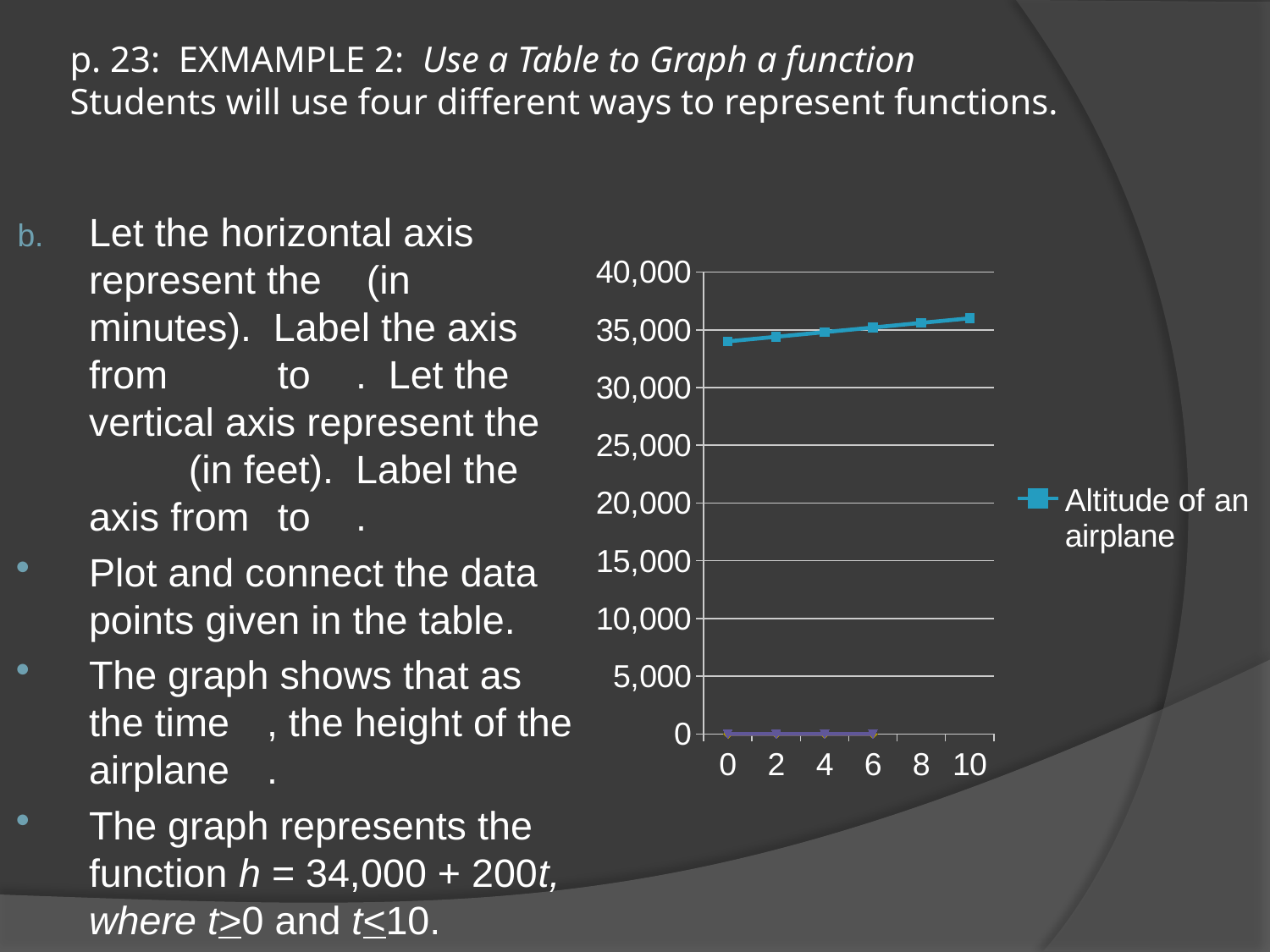
Is the altitude of the airplane at time 10 greater or less than 35,000? greater What is the highest value labelled on the chart's vertical axis? 40,000 At which x-axis value is the altitude of the airplane highest? 10 What is the name of the series shown in the chart's legend? Altitude of an airplane At which x-axis value is the altitude of the airplane lowest? 0 Is the altitude of the airplane at time 0 greater or less than 30,000? greater How many series does the chart's legend list? 1 How many tick labels are shown on the x axis of the chart? 6 What kind of chart is shown on the slide? line chart Does the altitude of the airplane rise or fall as the time along the x axis increases? rise Which is larger, the altitude of the airplane at time 2 or at time 10? time 10 Is the altitude of the airplane at time 0 greater or less than 35,000? less